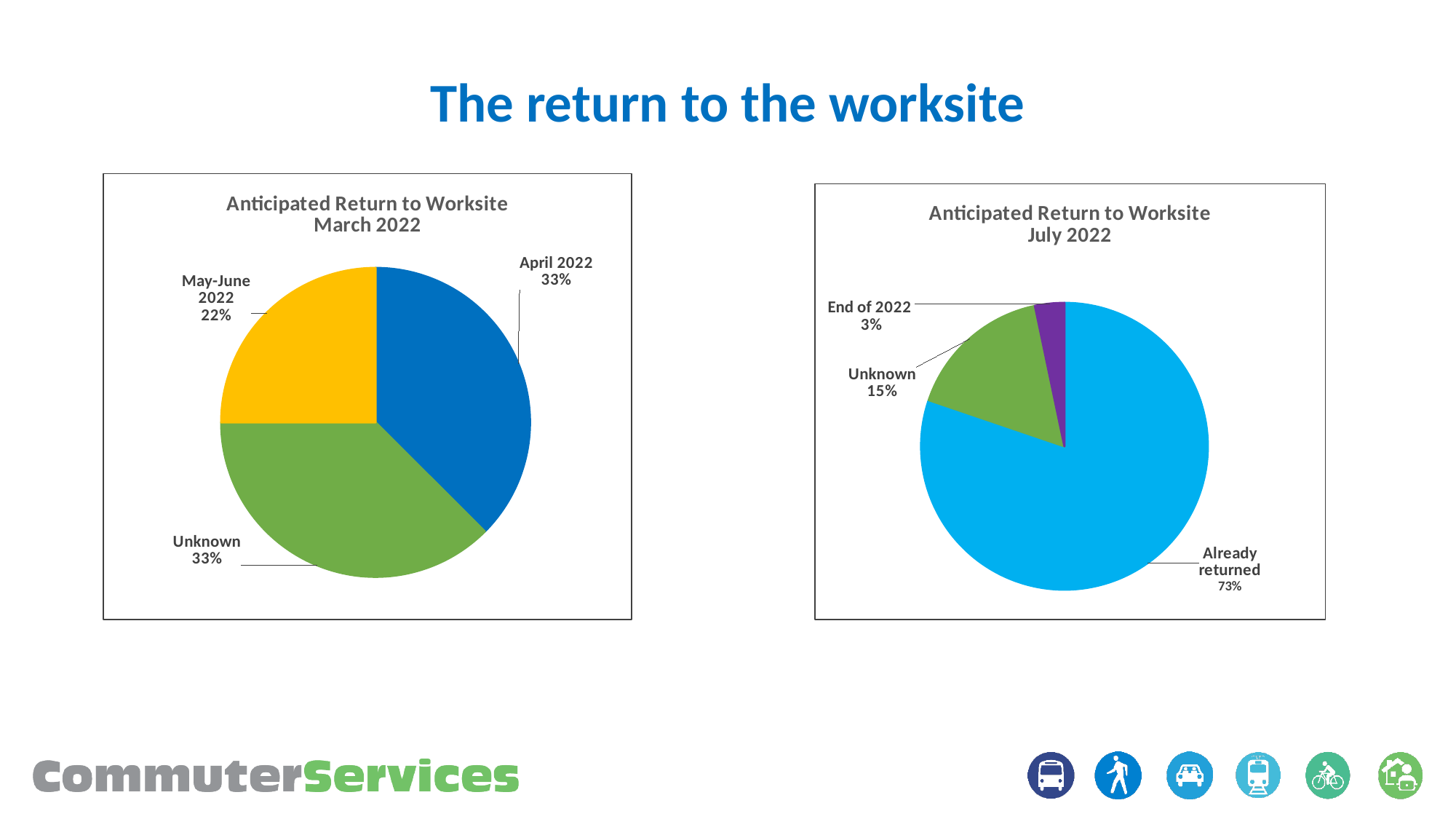
How many slices does the 'Anticipated Return to Worksite July 2022' chart have? 3 In the 'Anticipated Return to Worksite July 2022' chart, what share is labelled for End of 2022? 3% In the 'Anticipated Return to Worksite March 2022' chart, which category has the smallest slice? May-June 2022 In the 'Anticipated Return to Worksite March 2022' chart, what share is labelled for May-June 2022? 22% In the 'Anticipated Return to Worksite July 2022' chart, what is the difference between the Already returned share and the Unknown share? 58% In the 'Anticipated Return to Worksite March 2022' chart, which is larger: the April 2022 slice or the May-June 2022 slice? April 2022 In the 'Anticipated Return to Worksite July 2022' chart, which category has the smallest slice? End of 2022 In the 'Anticipated Return to Worksite July 2022' chart, what share is labelled for Unknown? 15% In the 'Anticipated Return to Worksite July 2022' chart, which category has the largest slice? Already returned In the 'Anticipated Return to Worksite March 2022' chart, what share is labelled for April 2022? 33% In the 'Anticipated Return to Worksite July 2022' chart, what share is labelled for Already returned? 73% What type of chart is the 'Anticipated Return to Worksite March 2022' chart? Pie chart